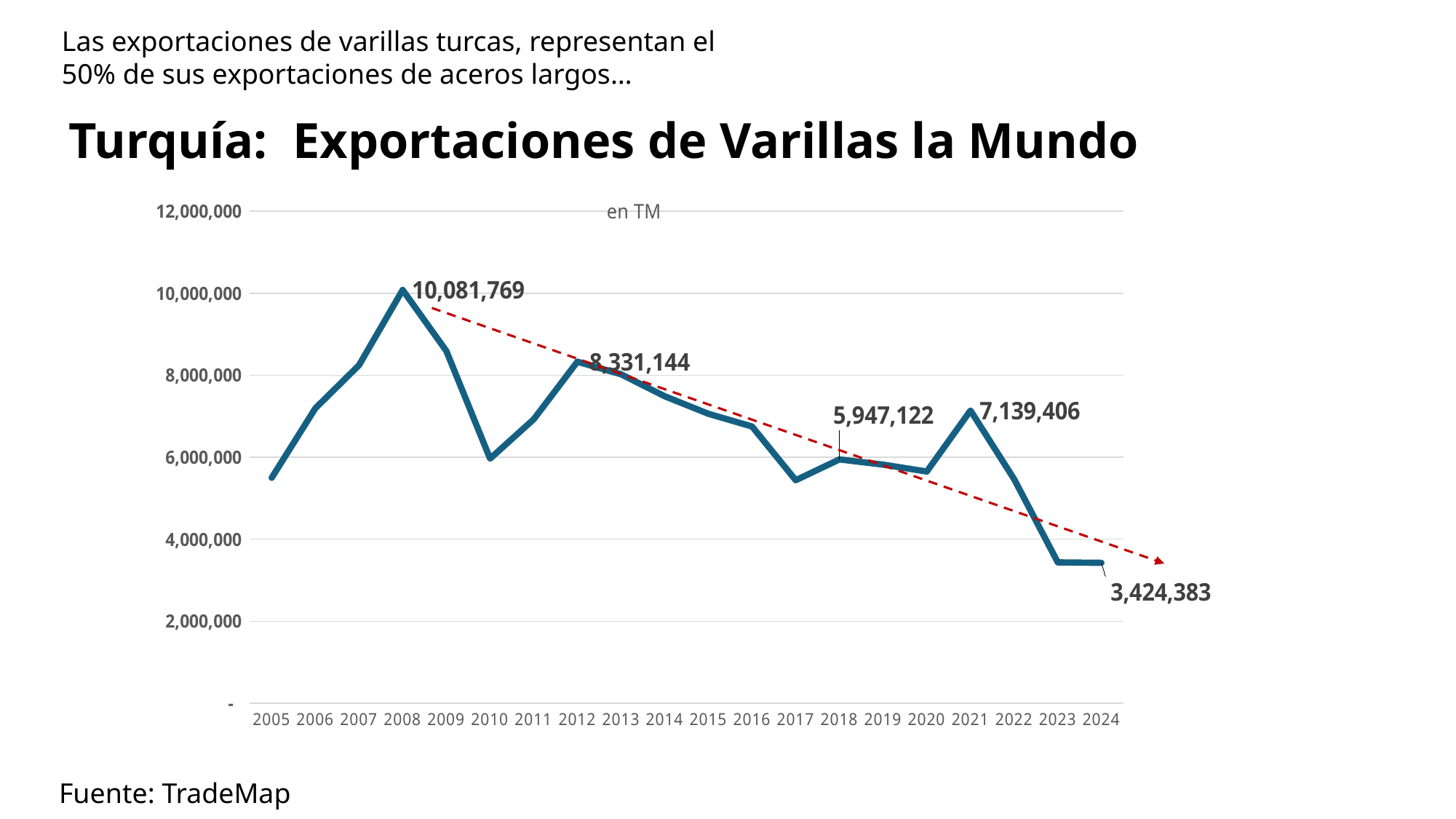
What is the value for 2008? 10,081,769 What is the value for 2018? 5,947,122 What is the value for 2024? 3,424,383 How many years are shown on the x axis? 20 What is the value for 2021? 7,139,406 Is the value for 2009 greater or less than 8,000,000? greater Is the value for 2017 greater or less than 6,000,000? less Which year has the highest value? 2008 What is the difference between the values for 2021 and 2018? 1,192,284 Which is larger, the value for 2012 or the value for 2021? 2012 What is the value for 2012? 8,331,144 What is the difference between the values for 2008 and 2024? 6,657,386